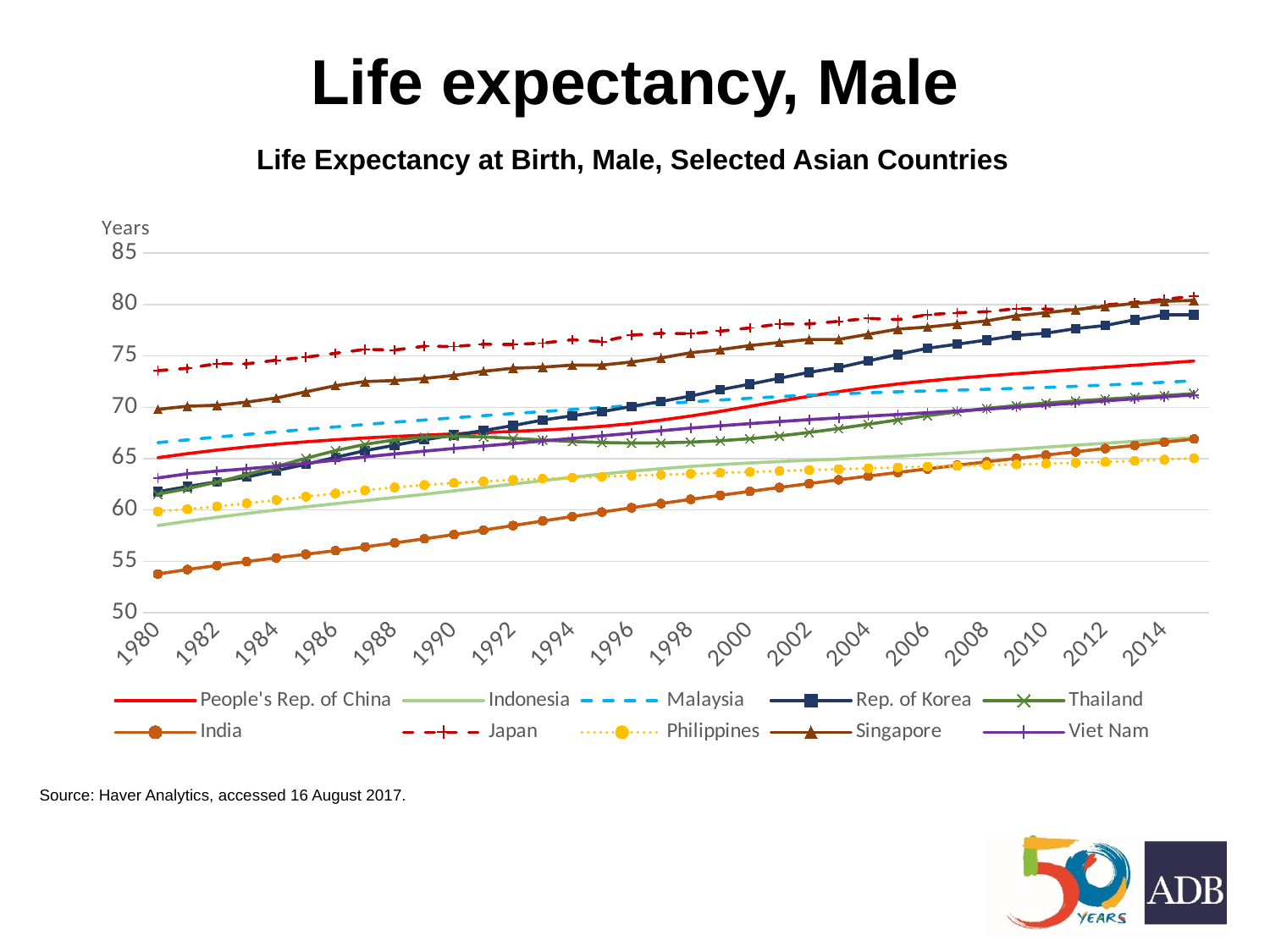
Which country has the lowest male life expectancy in 1980? India Does the male life expectancy for India rise or fall from 1980 to 2014? Rises Is the value for India in 1980 greater or less than 55? less Which country has the lowest male life expectancy at the end of the series (2015)? Philippines What unit is shown on the vertical axis of the chart? Years What kind of chart is shown on the slide? Line chart Which country has the highest male life expectancy in 1980? Japan Is the value for Indonesia in 1980 greater or less than 60? less How many series does the legend list? 10 Is the value for Japan in 1980 greater or less than 70? greater In 1980, which is larger: the value for Singapore or the value for Rep. of Korea? Singapore